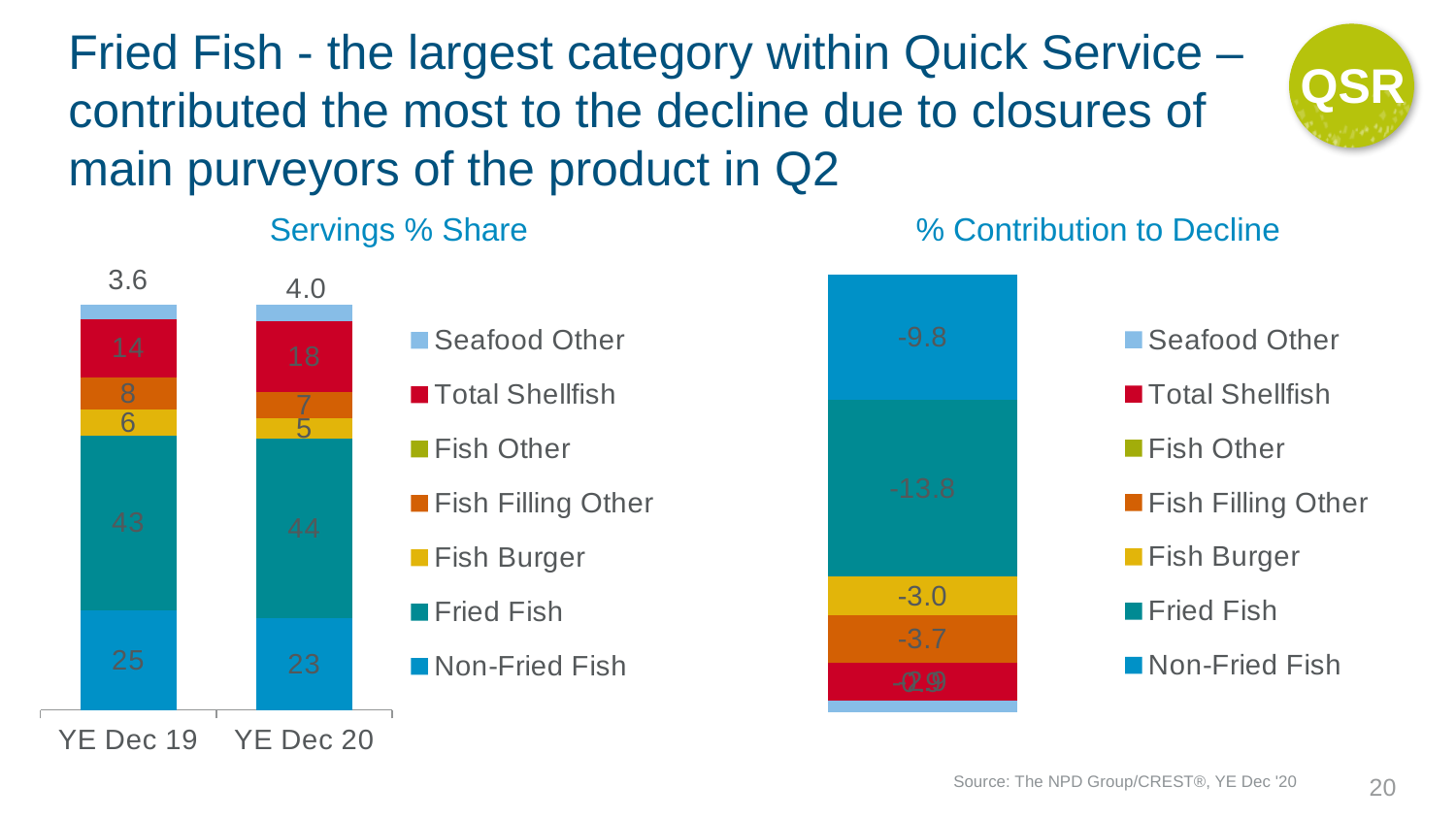
In the Servings % Share chart, what is the value for Fried Fish in YE Dec 19? 43 What kind of chart is the % Contribution to Decline chart? Stacked bar chart In the Servings % Share chart, what is the value for Non-Fried Fish in YE Dec 20? 23 In the % Contribution to Decline chart, what is the value for Non-Fried Fish? -9.8 In the Servings % Share chart, by how much did the Total Shellfish share increase from YE Dec 19 to YE Dec 20? 4 In the Servings % Share chart, which category has the largest share in YE Dec 20? Fried Fish In the Servings % Share chart, is the Non-Fried Fish share larger in YE Dec 19 or YE Dec 20? YE Dec 19 How many series does the legend of the Servings % Share chart list? 7 In the Servings % Share chart, what is the value shown above the YE Dec 19 bar for Seafood Other? 3.6 In the Servings % Share chart, what is the value for Total Shellfish in YE Dec 20? 18 In the % Contribution to Decline chart, what is the value for Fried Fish? -13.8 How many bars are shown in the Servings % Share chart? 2